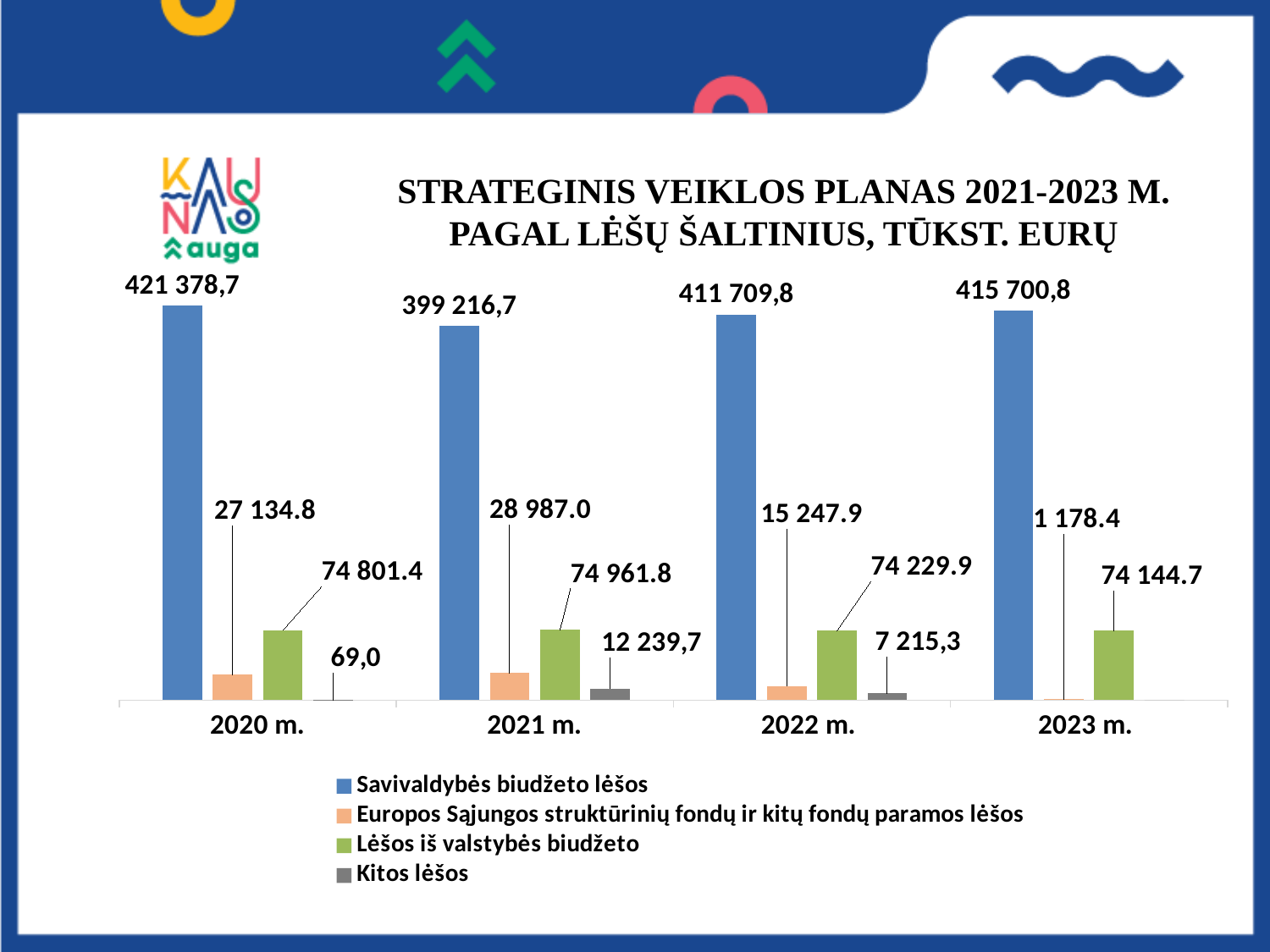
How many years are shown on the x axis? 4 What is the value of Kitos lėšos for 2021 m.? 12 239,7 From 2021 m. to 2023 m., do the values for Europos Sąjungos struktūrinių fondų ir kitų fondų paramos lėšos rise or fall? Fall In which year is Savivaldybės biudžeto lėšos highest? 2020 m. How many series does the legend list? 4 What is the value of Europos Sąjungos struktūrinių fondų ir kitų fondų paramos lėšos for 2023 m.? 1 178.4 What is the value of Savivaldybės biudžeto lėšos for 2020 m.? 421 378,7 Which is larger: Kitos lėšos in 2021 m. or in 2022 m.? 2021 m. What is the value of Lėšos iš valstybės biudžeto for 2022 m.? 74 229.9 What kind of chart is shown on the slide? Bar chart What is the difference between Savivaldybės biudžeto lėšos in 2020 m. and 2021 m.? 22 162,0 In which year is Europos Sąjungos struktūrinių fondų ir kitų fondų paramos lėšos lowest? 2023 m.